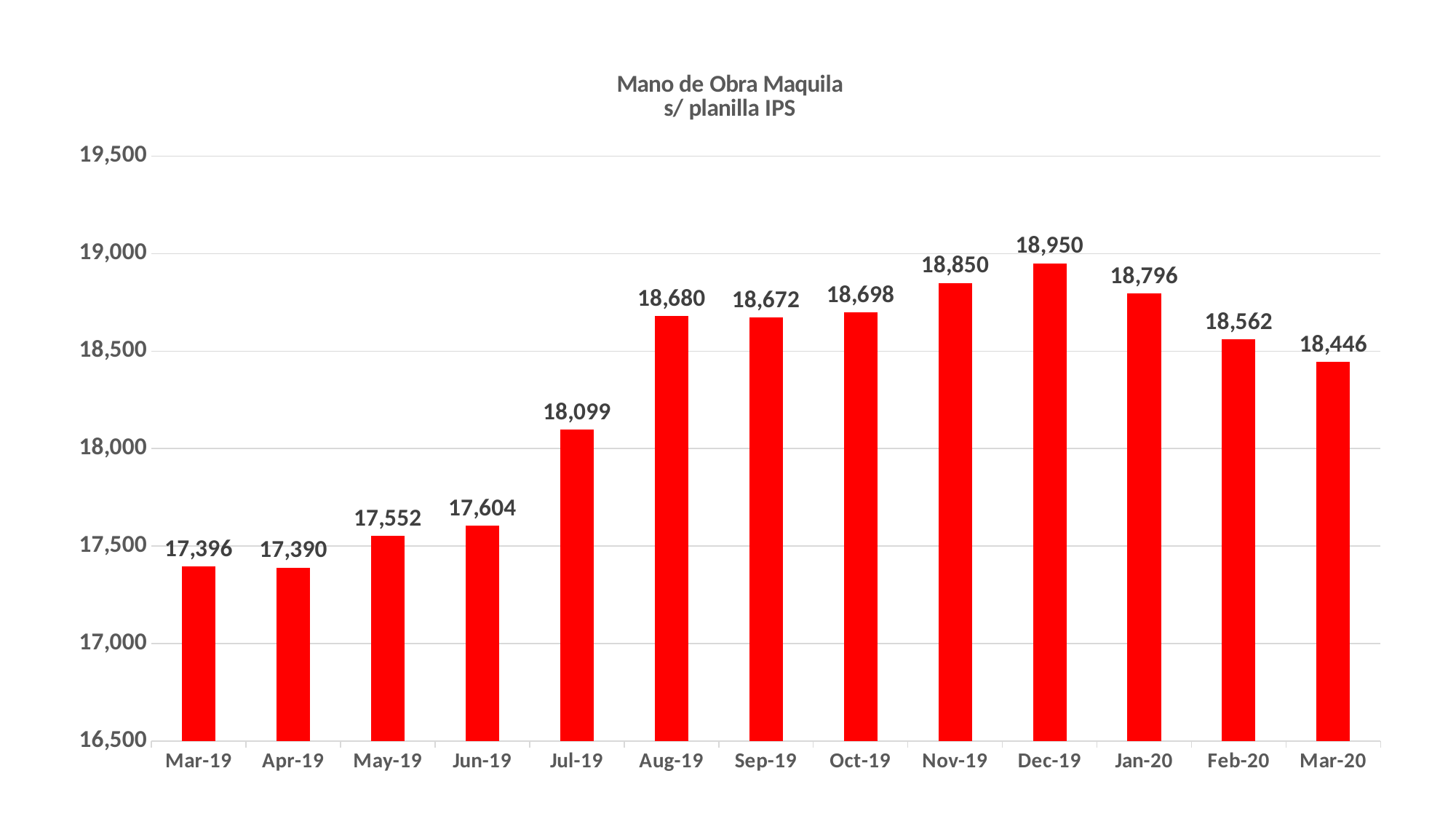
Which is larger, the value for Aug-19 or the value for Sep-19? Aug-19 Which month has the highest value? Dec-19 Is the value for Jun-19 greater or less than 18,000? less What kind of chart is shown? bar chart Do the values rise or fall from Mar-19 to Dec-19? rise What is the difference between the values for Dec-19 and Mar-20? 504 What is the value for Jul-19? 18,099 Which month has the lowest value? Apr-19 How many months are shown on the x axis? 13 What is the value for Mar-19? 17,396 What is the value for Dec-19? 18,950 What is the title of the chart? Mano de Obra Maquila s/ planilla IPS